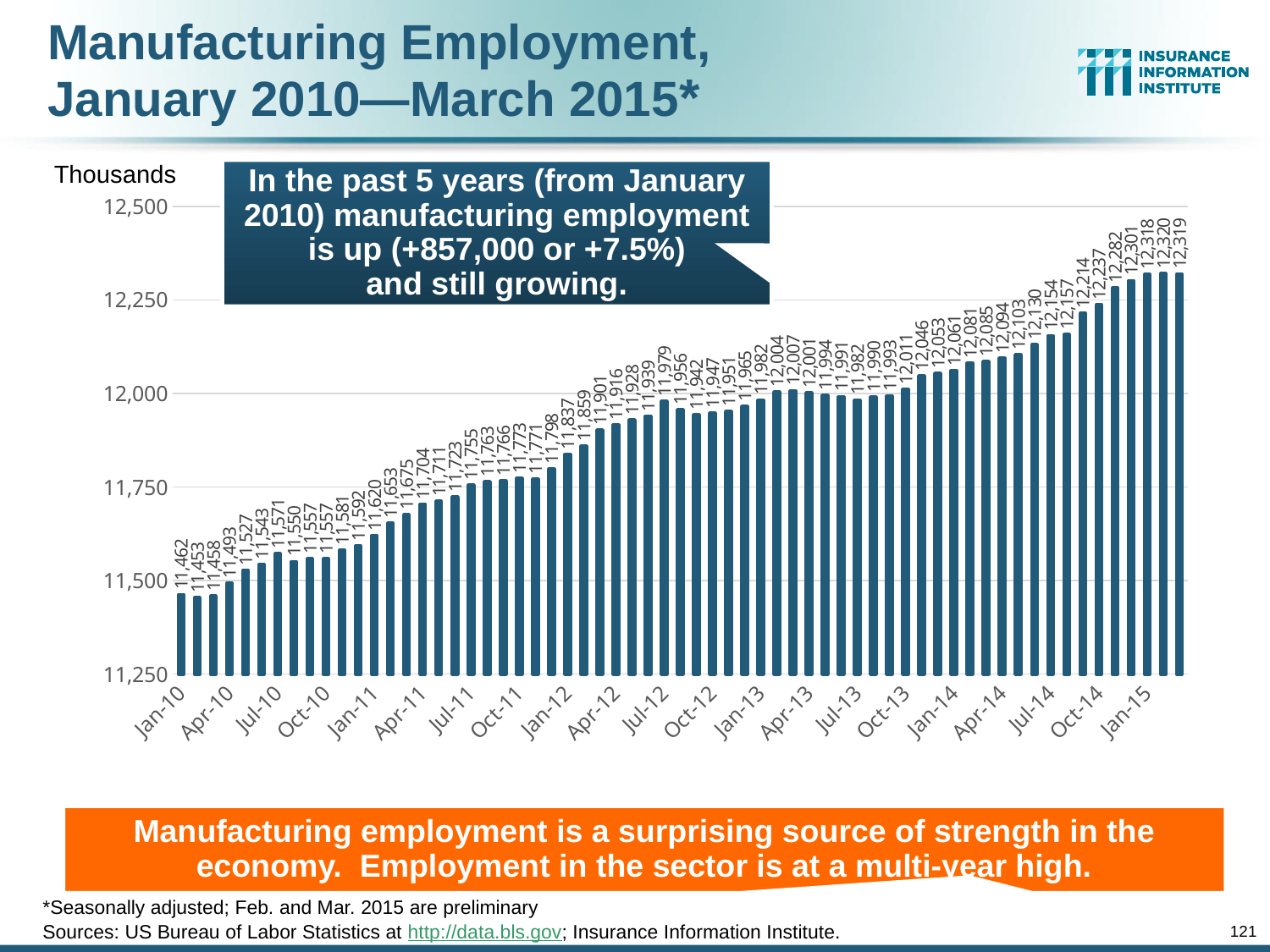
What is the highest value shown on the chart? 12,320 Which is larger, the value for Jan-12 or the value for Jan-14? Jan-14 What is the lowest value shown on the chart? 11,453 Is the value for Jan-12 greater or less than 11,750? greater What is the manufacturing employment value for Jan-15? 12,318 Do the values generally rise or fall from Jan-10 to Jan-15? Rise How many monthly bars are plotted on the chart? 63 What is the manufacturing employment value for Jan-10? 11,462 What is the difference between the Jan-15 value and the Jan-10 value? 856 What kind of chart is shown on the slide? Bar chart What unit is indicated for the vertical axis of the chart? Thousands What is the manufacturing employment value for Jan-13? 11,982